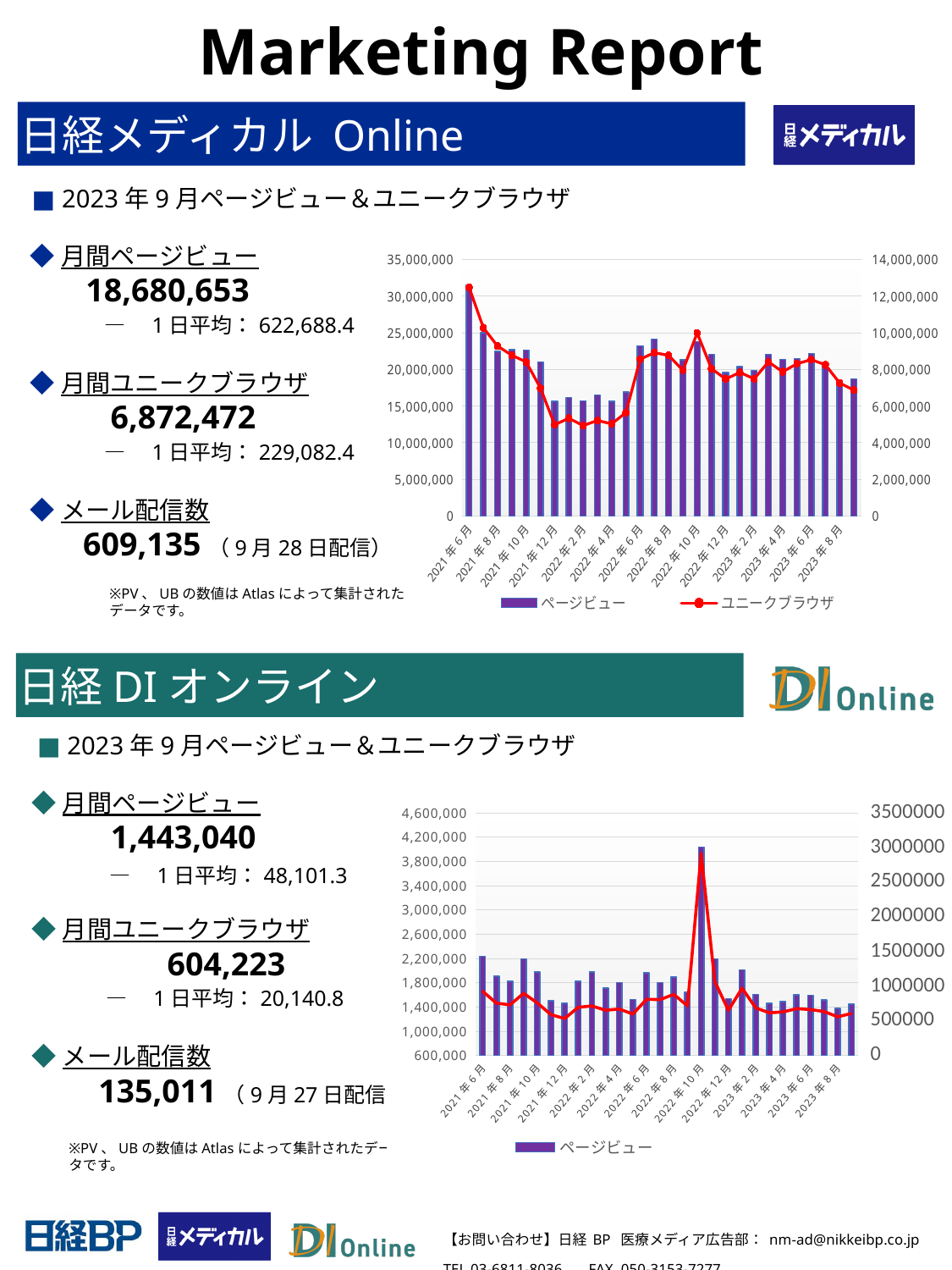
In the 日経DIオンライン chart, is the page view value for 2022年10月 greater or less than 3,400,000? greater In the 日経メディカル Online chart, is the unique browser (ユニークブラウザ) value for 2021年6月 greater or less than 10,000,000? greater In the 日経メディカル Online chart, which month has the highest page views (ページビュー)? 2021年6月 In the 日経メディカル Online chart, which series is drawn as a red line? ユニークブラウザ How many series does the legend of the 日経メディカル Online chart list? 2 In the 日経メディカル Online chart, which is larger: page views in 2021年6月 or in 2023年8月? 2021年6月 In the 日経DIオンライン chart, which month has the highest page views? 2022年10月 In the 日経メディカル Online chart, do page views rise or fall from 2021年6月 to 2021年12月? fall In the 日経メディカル Online chart, is the page view value for 2021年6月 greater or less than 25,000,000? greater In the 日経DIオンライン chart, do page views rise or fall from 2022年10月 to 2022年12月? fall How many series does the legend of the 日経DIオンライン chart list? 1 What kind of chart is shown in the 日経メディカル Online section? A combined bar and line chart